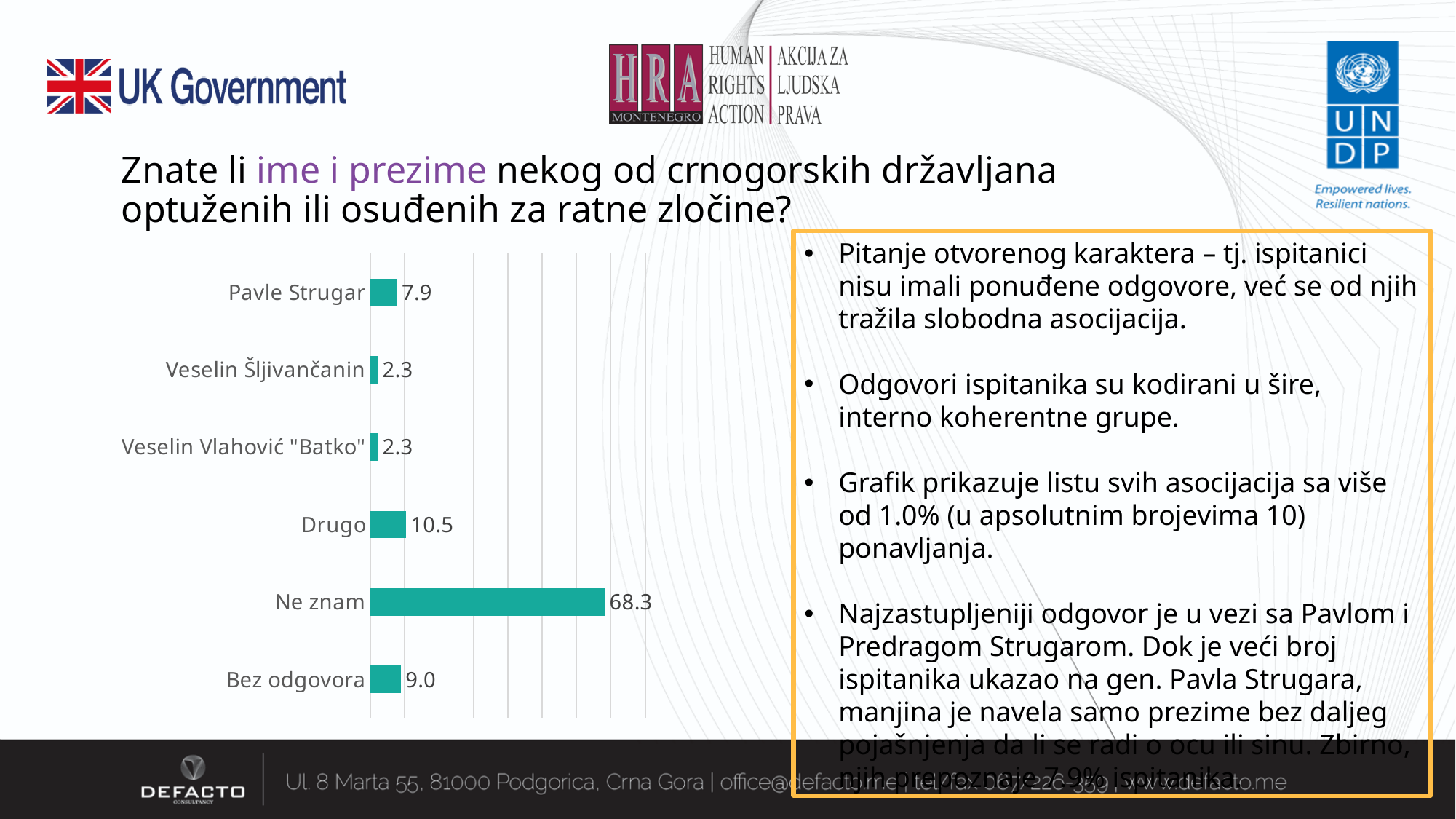
What value is shown for Drugo? 10.5 What kind of chart is shown on the slide? Bar chart What value is shown for Veselin Šljivančanin? 2.3 What is the difference between the values for Drugo and Pavle Strugar? 2.6 What value is shown for Bez odgovora? 9.0 What value is shown for Ne znam? 68.3 What colour are the bars in the chart? Teal How many categories are shown in the chart? 6 What value is shown for Pavle Strugar? 7.9 What is the difference between the values for Ne znam and Drugo? 57.8 Which category has the highest value? Ne znam Which is larger, the value for Bez odgovora or the value for Pavle Strugar? Bez odgovora